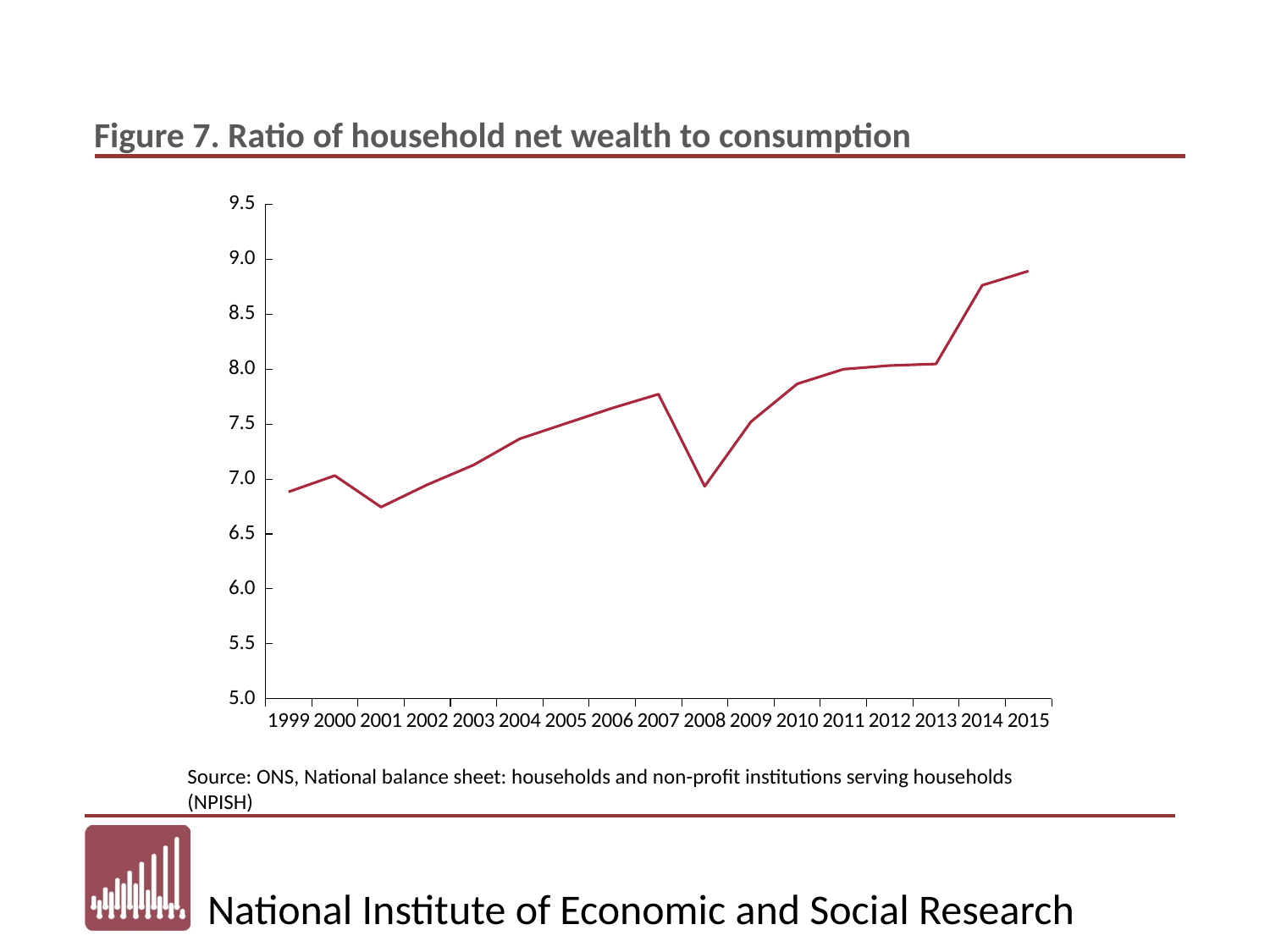
Which year has the highest ratio of household net wealth to consumption? 2015 Overall, does the ratio rise or fall between 1999 and 2015? rise How many years are shown on the x axis of the chart? 17 Is the value for 2015 greater or less than 8.5? greater What is the title of the chart? Figure 7. Ratio of household net wealth to consumption Is the value for 2004 greater or less than 7.5? less Is the value for 2007 greater or less than 7.5? greater Which year has the larger value, 2007 or 2008? 2007 Which year has the lowest ratio of household net wealth to consumption? 2001 What kind of chart is shown on the slide? line chart